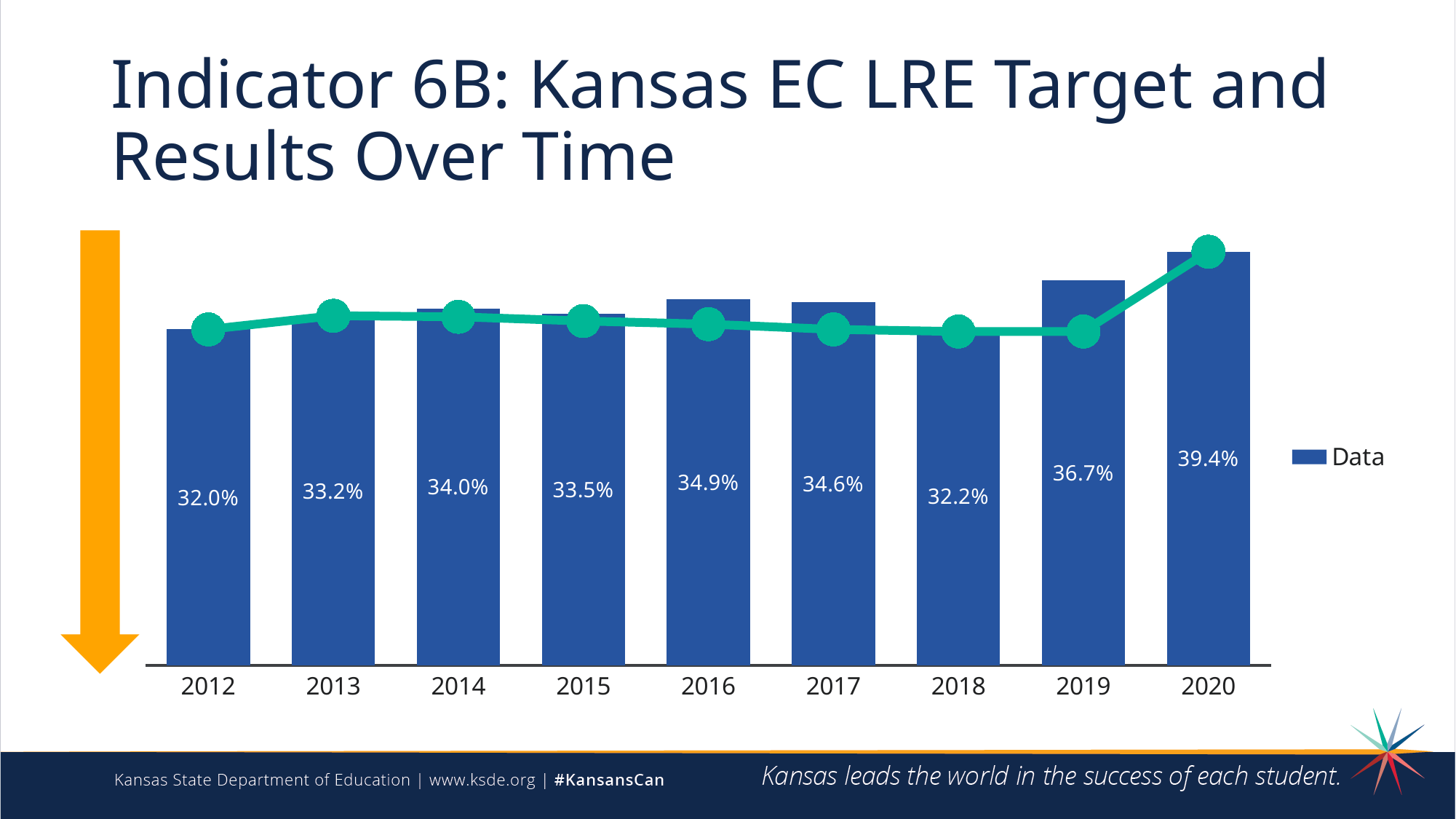
What kind of chart is used to show the Data values? Bar chart Which year has the lowest Data value? 2012 How many years are shown on the x axis? 9 How many entries does the legend list? 1 Which year has a larger Data value, 2014 or 2015? 2014 What is the difference between the Data values for 2020 and 2019? 2.7 percentage points What is the Data value for 2016? 34.9% What is the Data value for 2012? 32.0% Which year has the highest Data value? 2020 What is the Data value for 2018? 32.2% What is the Data value for 2020? 39.4% Do the Data values rise or fall from 2018 to 2020? Rise